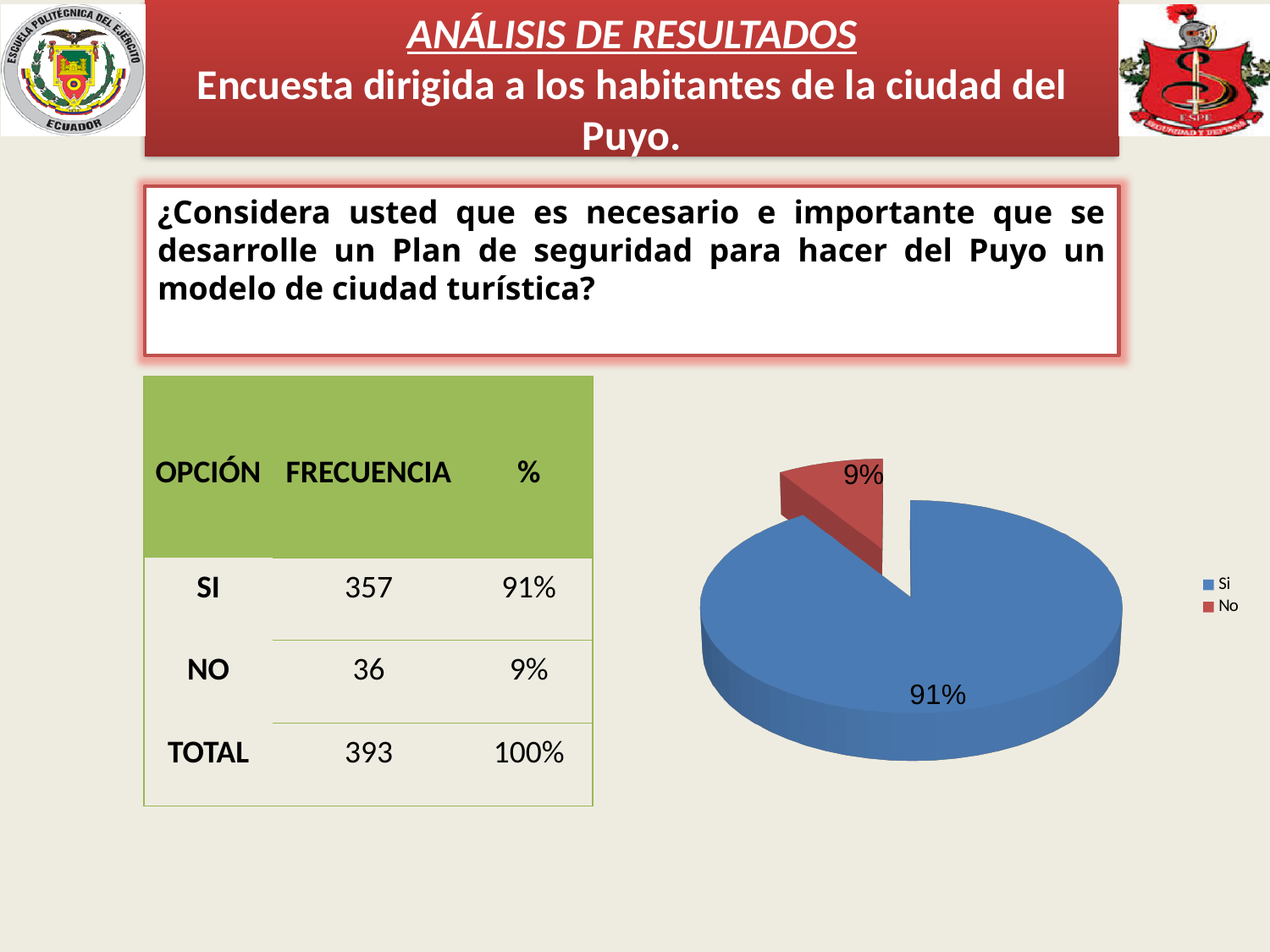
What colour is the No slice in the pie chart? red Which slice of the pie chart is the largest? Si Which is larger in the pie chart, Si or No? Si What kind of chart is shown on the slide? pie chart What share of the pie does the Si slice represent? 91% How many entries does the legend of the pie chart list? 2 How many slices does the pie chart have? 2 What colour is the Si slice in the pie chart? blue What is the difference in percentage points between the Si and No slices? 82 What percentage does the pie chart show for No? 9% Which slice of the pie chart is the smallest? No What percentage does the pie chart show for Si? 91%